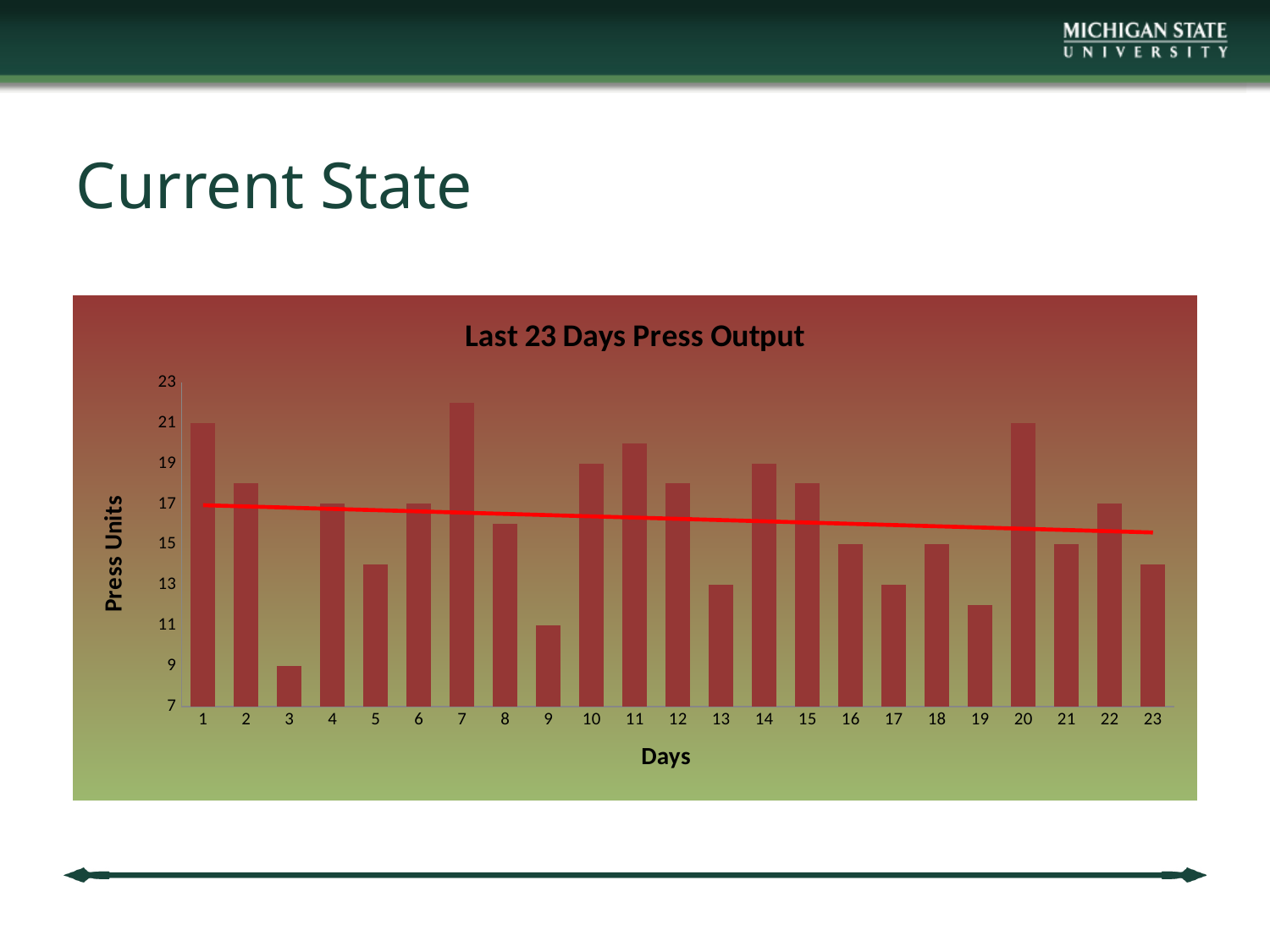
What is the label on the vertical axis of the chart? Press Units Which day has the highest press output? Day 7 How many days (bars) are plotted in the chart? 23 What type of chart is shown on the slide? Bar chart What is the press output on Day 20? 21 Is the press output on Day 7 greater or less than 21? greater Does the red trend line across the chart rise or fall from Day 1 to Day 23? Fall Is the press output on Day 19 greater or less than 13? less What is the title of the chart? Last 23 Days Press Output What is the press output on Day 9? 11 What is the press output on Day 3? 9 Which day has the lowest press output? Day 3